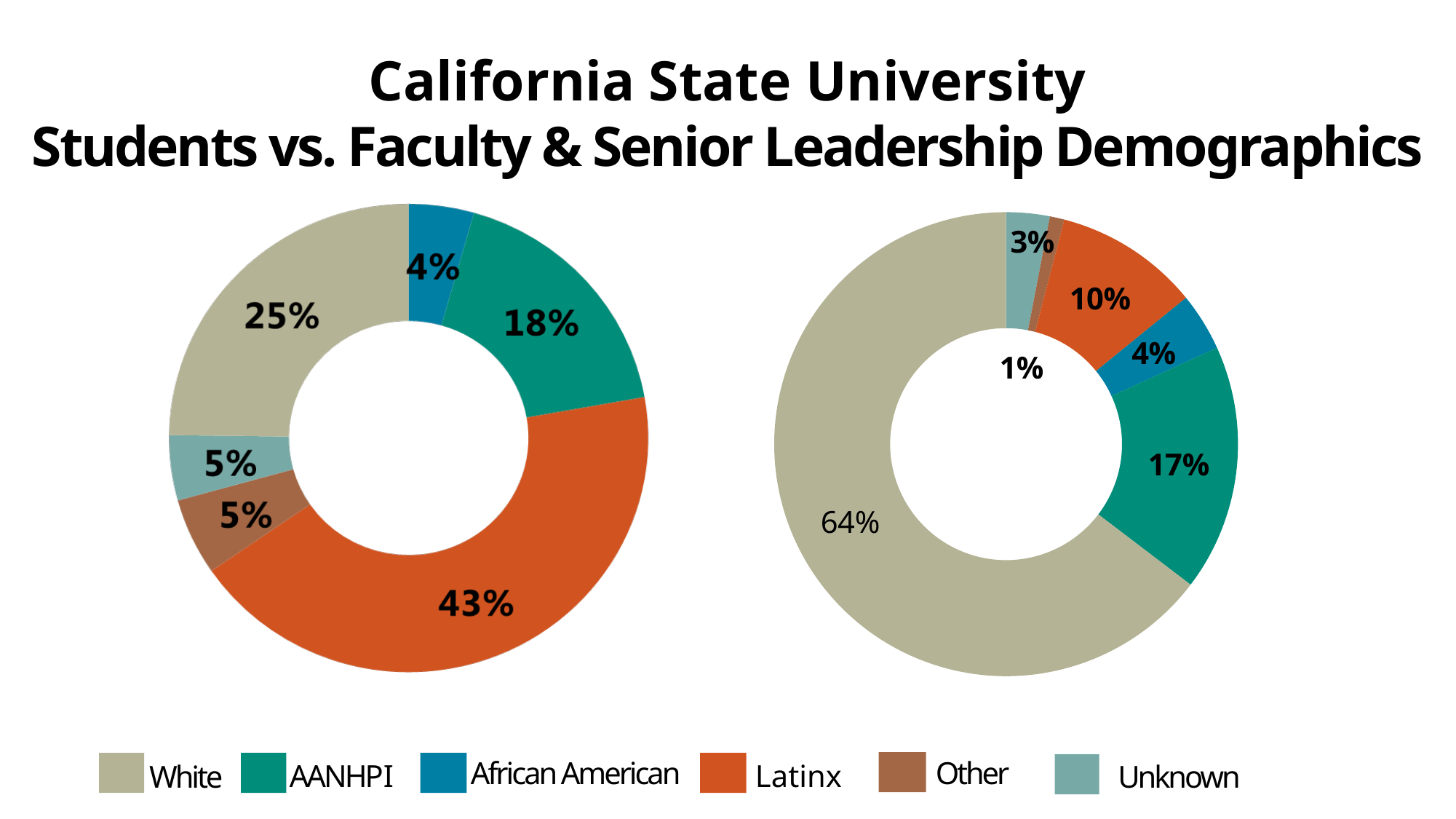
In the right donut chart, which category has the smallest share? Other Which colour represents Unknown in the legend? Light teal Which is larger: the Latinx share in the left donut chart or the Latinx share in the right donut chart? Left donut chart In the left donut chart, what percentage is shown for Latinx? 43% In the left donut chart, what is the difference between the Latinx share and the AANHPI share? 25 percentage points In the right donut chart, what percentage is shown for AANHPI? 17% In the left donut chart, which category has the largest share? Latinx In the left donut chart, which category has the smallest share? African American What is the difference between the White share in the right donut chart and the White share in the left donut chart? 39 percentage points How many categories does the legend list? 6 In the right donut chart, what percentage is shown for White? 64% What kind of charts are shown on the slide? Pie (donut) charts